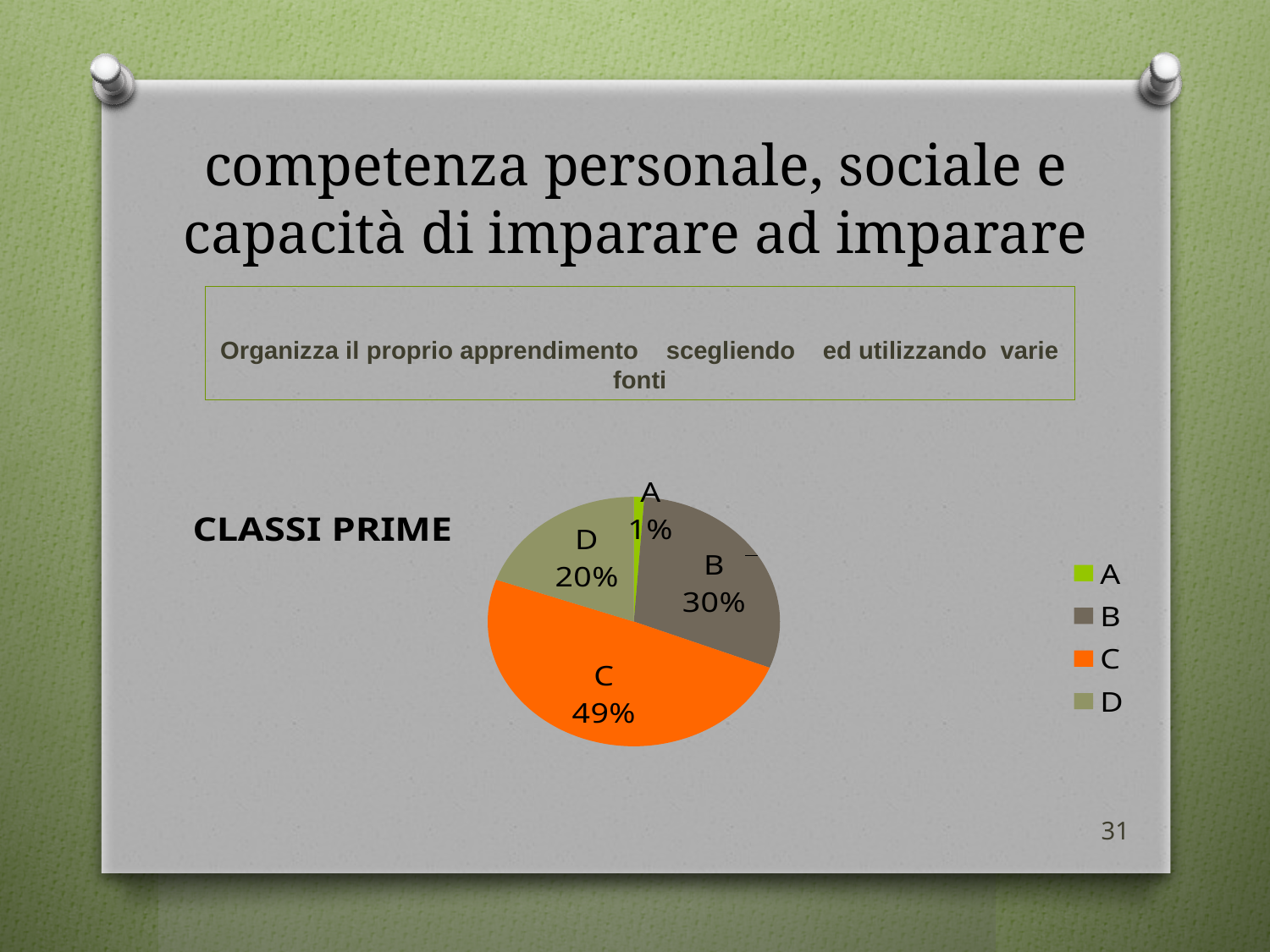
What percentage does slice D represent in the pie chart? 20% What kind of chart is shown on the slide? pie chart What is the difference in percentage points between slice C and slice B? 19 How many entries does the legend list? 4 What percentage does slice A represent in the pie chart? 1% What colour is the slice for category C in the pie chart? orange What percentage does slice B represent in the pie chart? 30% Which category has the largest share of the pie chart? C How many slices does the pie chart have? 4 What percentage does slice C represent in the pie chart? 49% Which is larger, the share for B or the share for D? B Which category has the smallest share of the pie chart? A